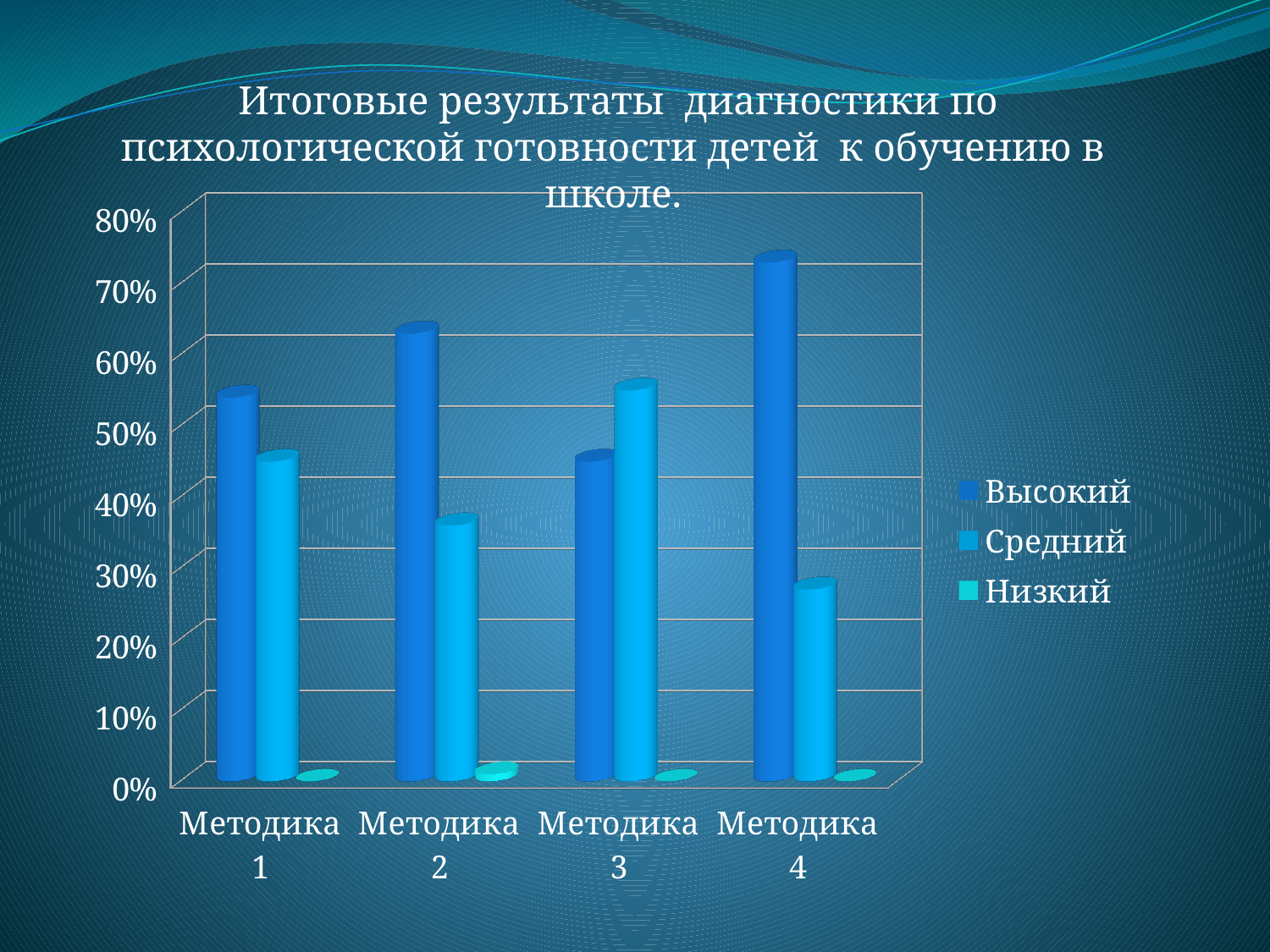
Is the Высокий value for Методика 4 greater or less than 70%? greater Is the Высокий value for Методика 2 greater or less than 60%? greater For which методика is the Средний value the highest? Методика 3 What kind of chart is shown on the slide? bar chart Which series is shown in the darkest blue colour in the legend? Высокий Is the Средний value for Методика 4 greater or less than 30%? less For Методика 3, which is larger: Высокий or Средний? Средний For which методика is the Высокий value the lowest? Методика 3 For which методика is the Высокий value the highest? Методика 4 For which методика is the Средний value the lowest? Методика 4 How many series does the legend list? 3 How many categories (методики) are shown on the x axis? 4